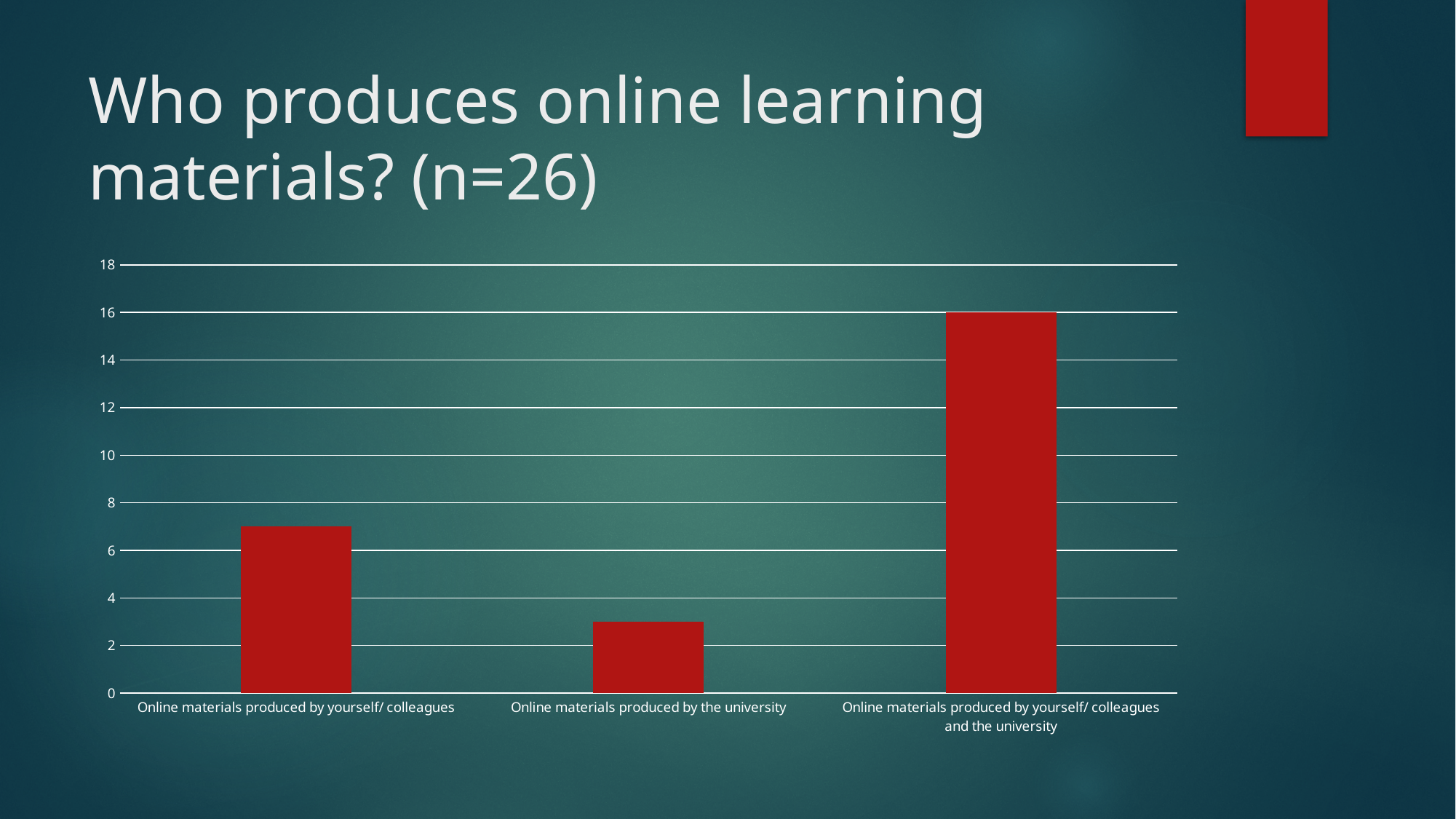
Is the value for 'Online materials produced by yourself/ colleagues' greater or less than 8? less How many categories are shown in the chart? 3 What kind of chart is shown on the slide? bar chart Which is larger: the value for 'Online materials produced by yourself/ colleagues' or the value for 'Online materials produced by the university'? Online materials produced by yourself/ colleagues Which category has the lowest value? Online materials produced by the university Is the value for 'Online materials produced by yourself/ colleagues' greater or less than 6? greater What is the maximum value shown on the vertical axis? 18 Is the value for 'Online materials produced by the university' greater or less than 2? greater What is the title of the slide containing the chart? Who produces online learning materials? (n=26) Which category has the highest value? Online materials produced by yourself/ colleagues and the university What is the value for 'Online materials produced by yourself/ colleagues and the university'? 16